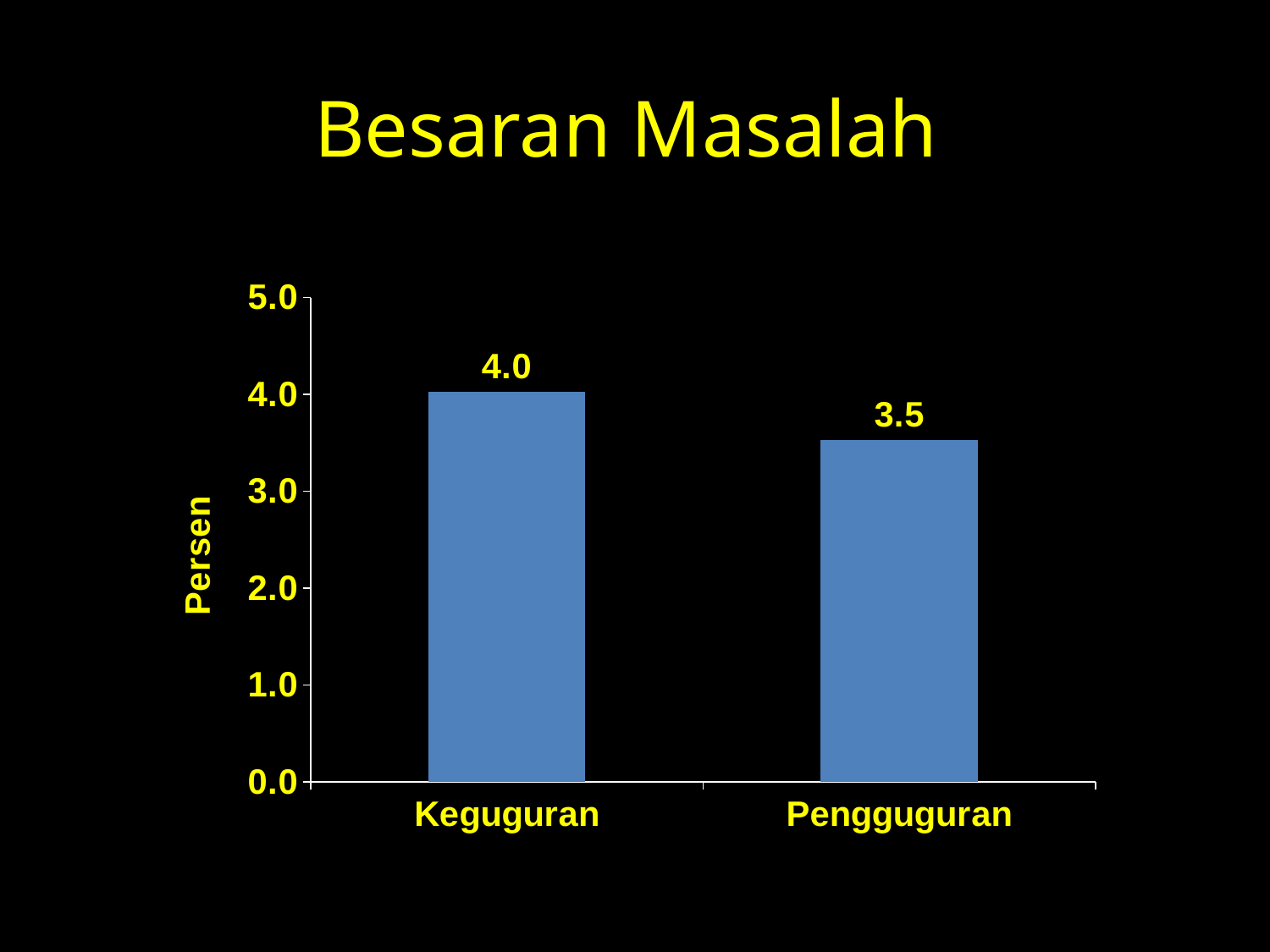
Which category has the lowest value? Pengguguran What is the title of the slide? Besaran Masalah Is the value for Pengguguran greater or less than 4.0? less What is the difference between the values for Keguguran and Pengguguran? 0.5 Which category has the highest value? Keguguran What is the label of the y axis? Persen Which is larger, the value for Keguguran or the value for Pengguguran? Keguguran What is the value for Keguguran? 4.0 How many categories are shown on the x axis? 2 What kind of chart is shown on the slide? bar chart Is the value for Keguguran greater or less than 3.0? greater What is the value for Pengguguran? 3.5